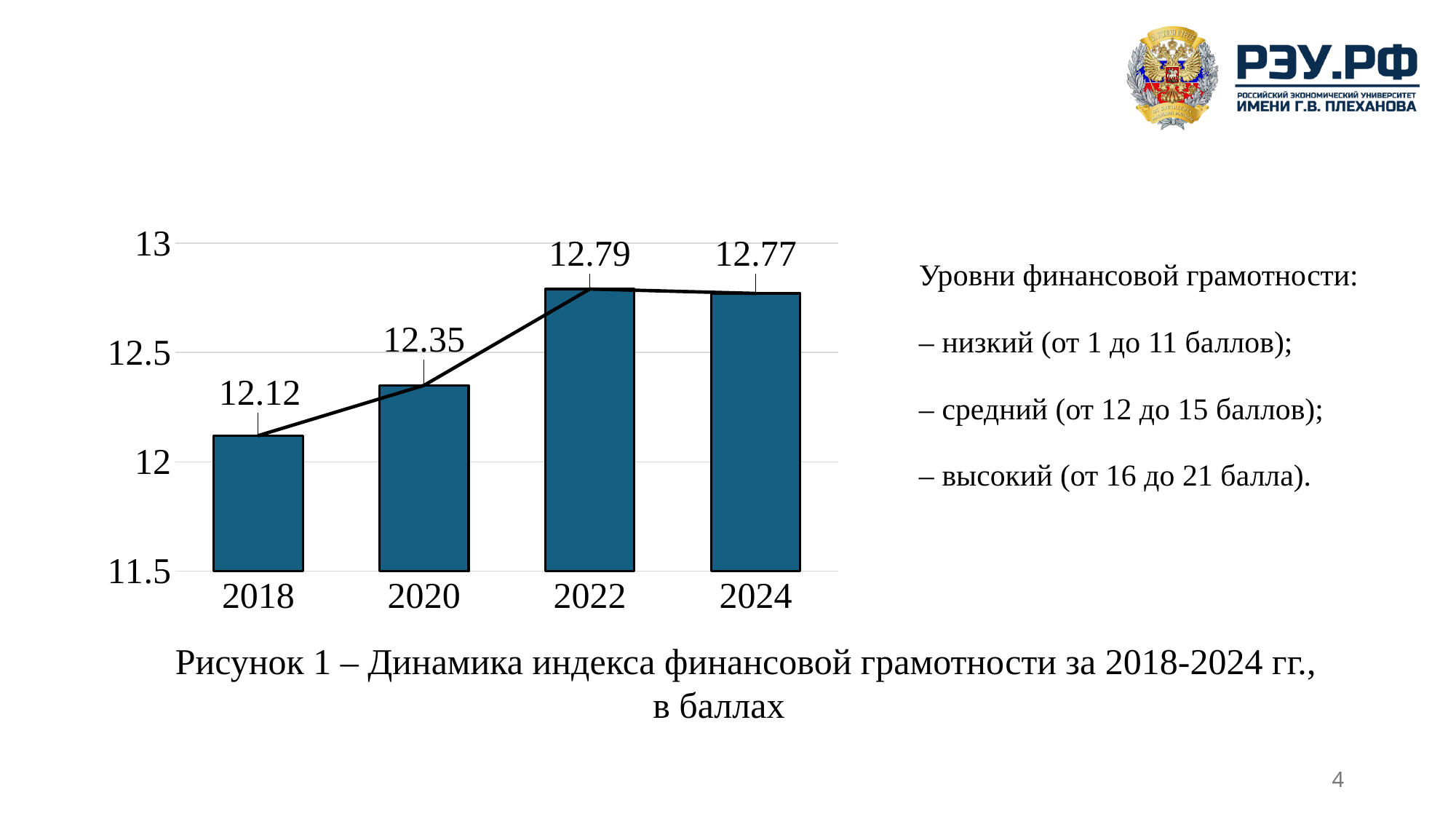
Which year has the lowest financial literacy index value? 2018 Which year has the highest financial literacy index value? 2022 Is the value for 2020 greater or less than 12.5? less What is the financial literacy index value for 2022? 12.79 How many years are shown on the x axis of the chart? 4 Which year has a larger index value, 2020 or 2024? 2024 What kind of chart is used to show the financial literacy index? combination bar and line chart What is the financial literacy index value for 2018? 12.12 What is the difference between the index values for 2022 and 2018? 0.67 Does the financial literacy index rise or fall from 2018 to 2022? rise What is the financial literacy index value for 2024? 12.77 What is the difference between the index values for 2020 and 2018? 0.23